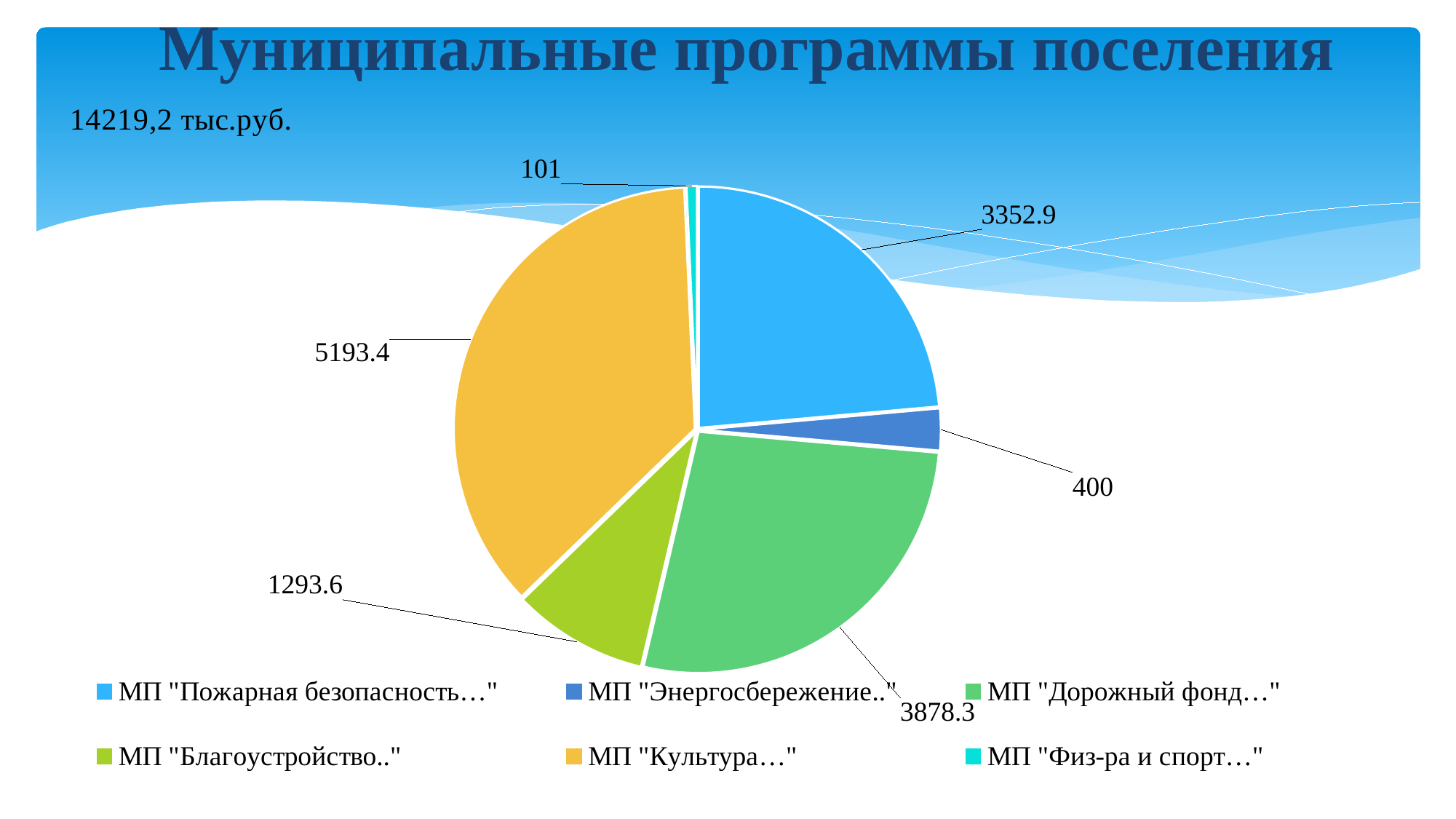
Which program has the largest slice of the pie? МП "Культура…" What is the difference between the values for МП "Благоустройство.." and МП "Энергосбережение.."? 893.6 Which is larger, the value for МП "Дорожный фонд…" or МП "Пожарная безопасность…"? МП "Дорожный фонд…" What is the value for МП "Дорожный фонд…"? 3878.3 What type of chart is shown on the slide? pie chart What is the difference between the values for МП "Культура…" and МП "Дорожный фонд…"? 1315.1 What is the title of the slide containing the chart? Муниципальные программы поселения What is the value for МП "Физ-ра и спорт…"? 101 Which program has the smallest slice of the pie? МП "Физ-ра и спорт…" How many slices does the pie chart have? 6 What is the value for МП "Культура…"? 5193.4 What is the value for МП "Энергосбережение.."? 400